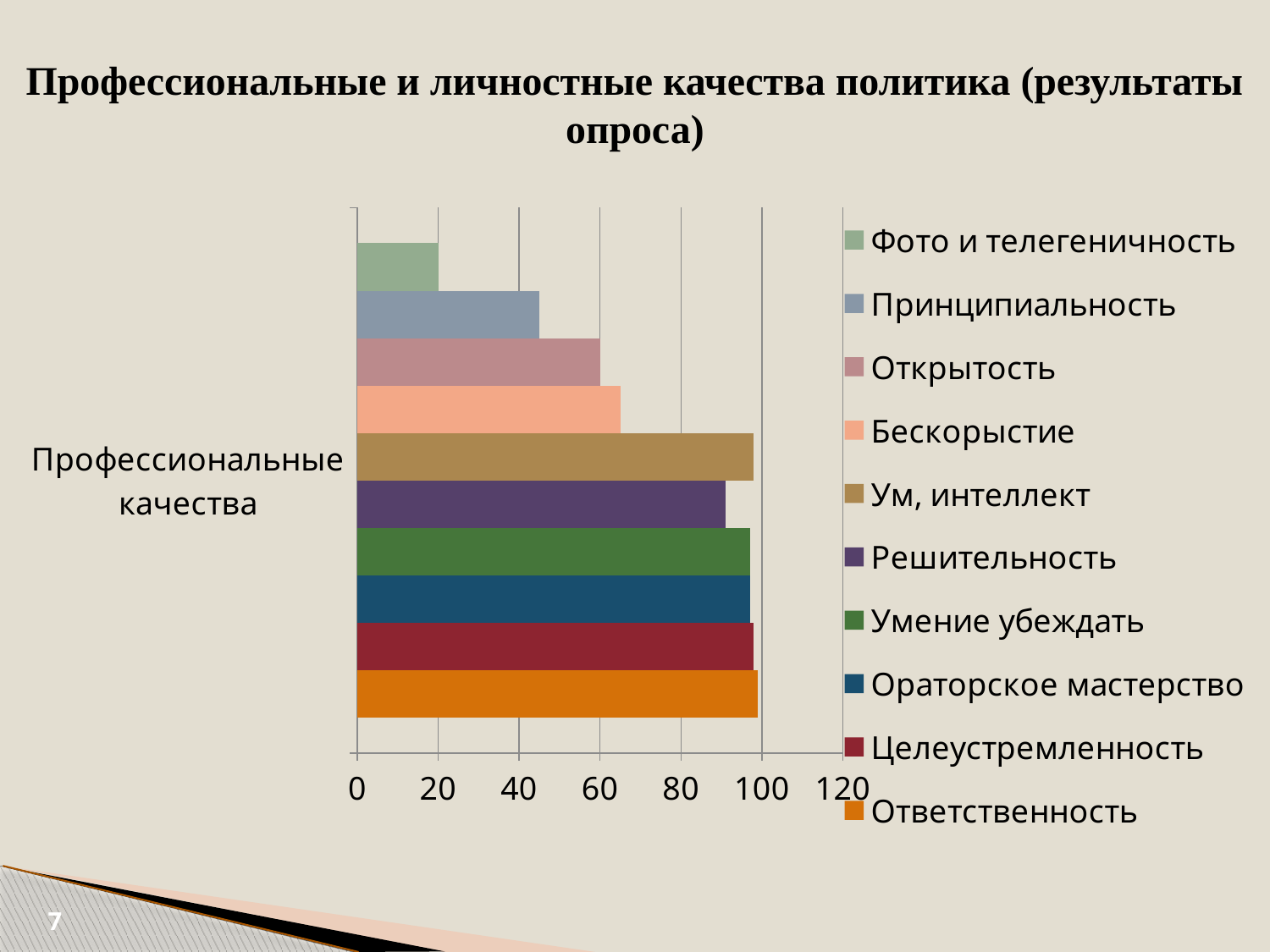
How many series does the legend list? 10 What kind of chart is shown on the slide? bar chart Which is larger, the value for Принципиальность or the value for Открытость? Открытость Is the value for Бескорыстие greater or less than 60? greater Is the value for Решительность greater or less than 80? greater Which is larger, the value for Бескорыстие or the value for Ум, интеллект? Ум, интеллект What is the label of the single category on the vertical axis? Профессиональные качества How many categories are shown on the vertical axis? 1 Is the value for Принципиальность greater or less than 60? less What is the value for Фото и телегеничность? 20 Which series has the lowest value? Фото и телегеничность